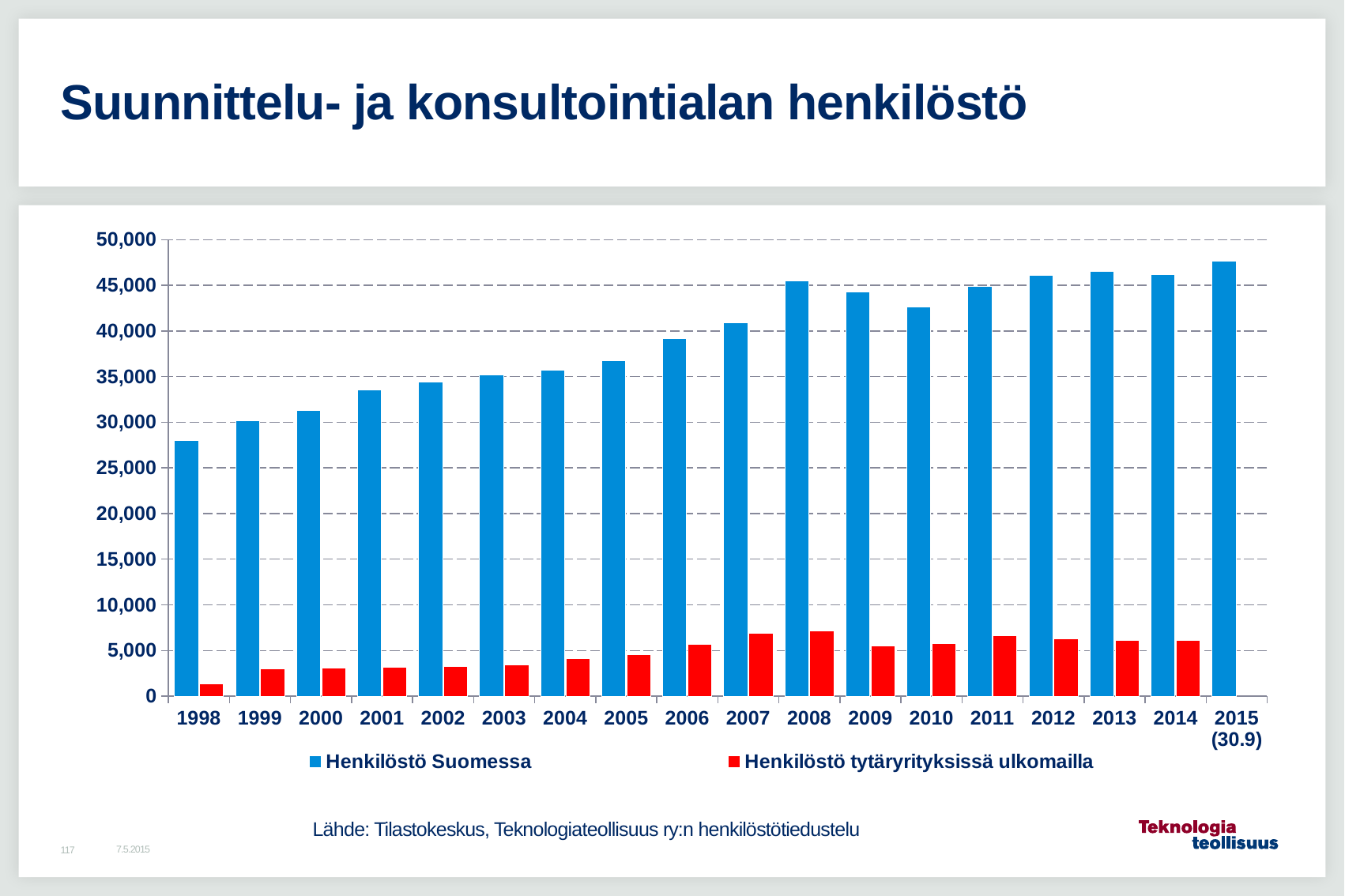
Which year has the lowest value for Henkilöstö Suomessa? 1998 Is the value for Henkilöstö Suomessa in 1998 greater or less than 30,000? less Which is larger in 2009: Henkilöstö Suomessa or Henkilöstö tytäryrityksissä ulkomailla? Henkilöstö Suomessa Which year has the lowest value for Henkilöstö tytäryrityksissä ulkomailla? 1998 Which year has the highest value for Henkilöstö Suomessa? 2015 (30.9) What type of chart is shown on the slide? bar chart How many years are shown on the x axis? 18 Is the value for Henkilöstö Suomessa in 2010 greater or less than 40,000? greater How many series does the legend list? 2 Is the value for Henkilöstö Suomessa in 2015 (30.9) greater or less than 45,000? greater Which colour represents Henkilöstö tytäryrityksissä ulkomailla in the chart? red